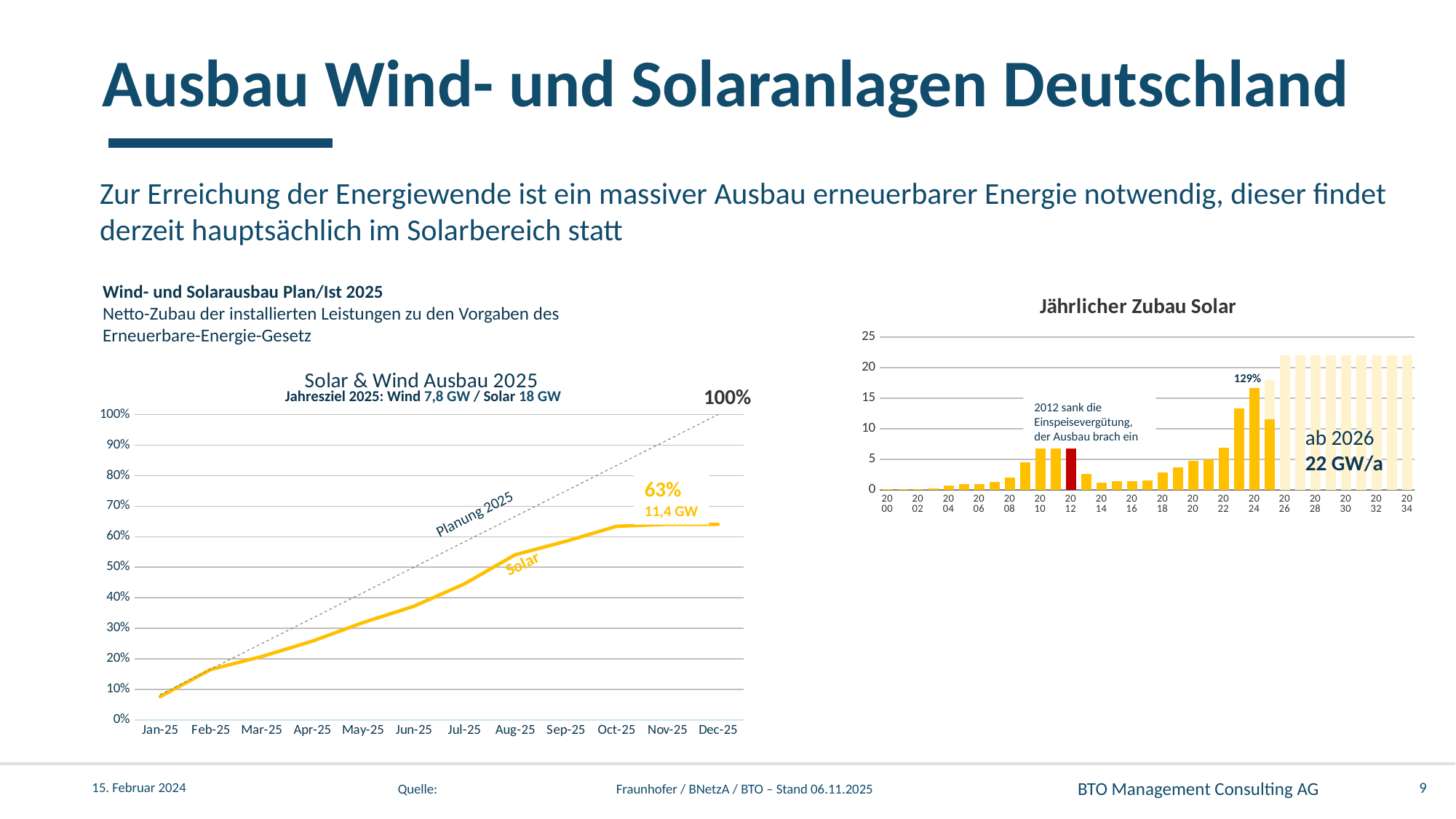
In the 'Solar & Wind Ausbau 2025' chart, how many GW does the Solar data label show? 11,4 GW In the 'Jährlicher Zubau Solar' chart, which year's bar is highlighted in red? 2012 In the 'Solar & Wind Ausbau 2025' chart, what percentage does the Solar line reach according to its data label? 63% What kind of chart is the 'Jährlicher Zubau Solar' chart on the right? bar chart In the 'Jährlicher Zubau Solar' chart, is the value for 2014 greater or less than 5? less In the 'Solar & Wind Ausbau 2025' chart, what value does the 'Planung 2025' dashed line reach at Dec-25? 100% In the 'Jährlicher Zubau Solar' chart, what percentage label is printed above the 2024 bar? 129% In the 'Solar & Wind Ausbau 2025' chart, does the Solar line rise or fall from Jan-25 to Dec-25? rise In the 'Solar & Wind Ausbau 2025' chart, is the Solar value at Aug-25 greater or less than 50%? greater In the 'Jährlicher Zubau Solar' chart, what annual addition is shown for the years from 2026 onward? 22 GW/a In the 'Solar & Wind Ausbau 2025' chart, how many months are shown on the x axis? 12 What kind of chart is the 'Solar & Wind Ausbau 2025' chart on the left? line chart